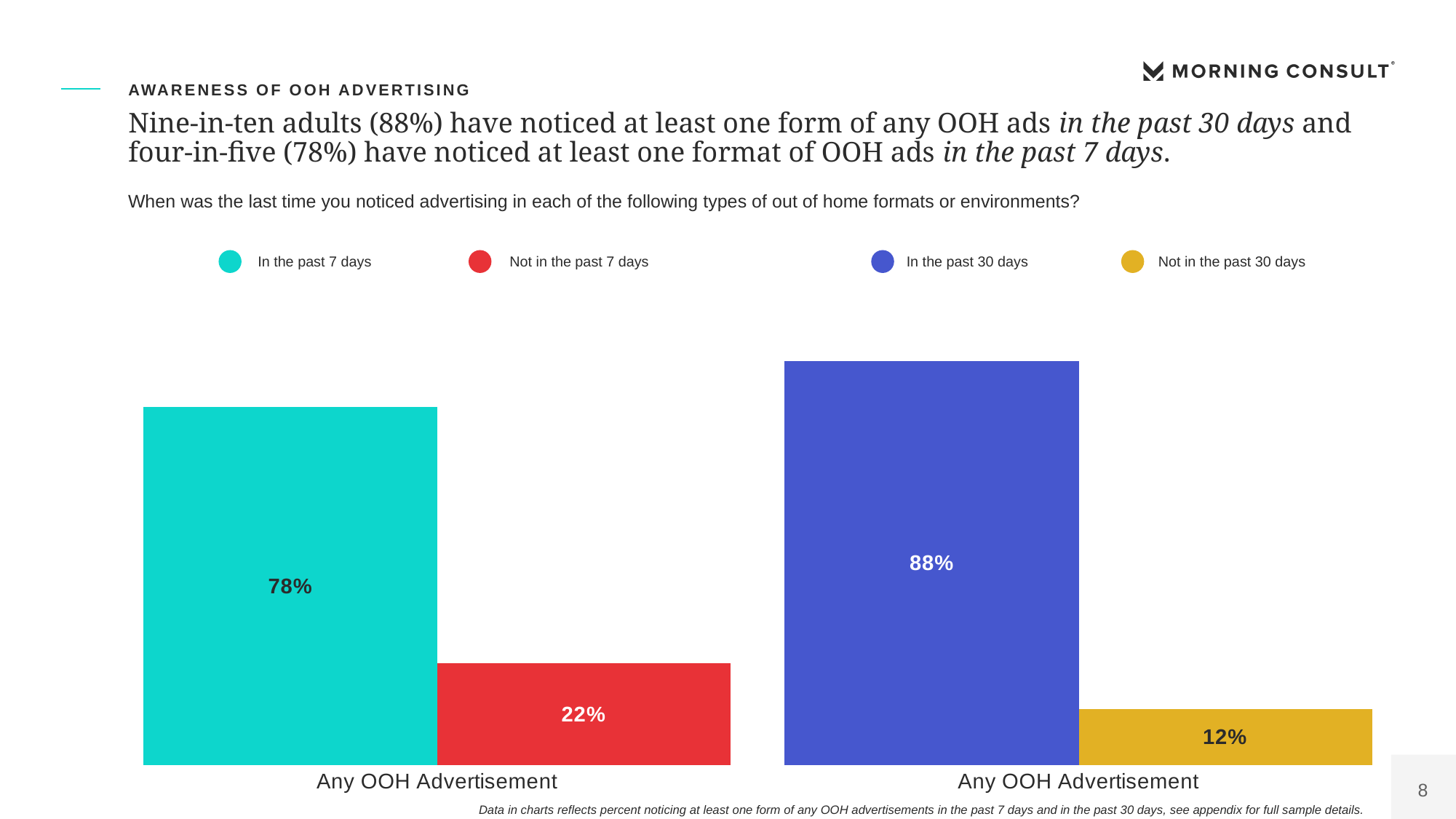
What percentage of adults did not notice any OOH advertisement in the past 7 days? 22% What colour is the bar for 'Not in the past 30 days'? Yellow What percentage of adults did not notice any OOH advertisement in the past 30 days? 12% What kind of chart is shown on the slide? Bar chart What percentage of adults noticed any OOH advertisement in the past 30 days? 88% What is the difference between the 'Not in the past 7 days' value and the 'Not in the past 30 days' value? 10% Which series has the lowest value in the chart? Not in the past 30 days Which is larger, the 'In the past 7 days' value or the 'Not in the past 7 days' value? In the past 7 days Which series has the highest value in the chart? In the past 30 days What percentage of adults noticed any OOH advertisement in the past 7 days? 78% What is the difference between the 'In the past 30 days' value and the 'In the past 7 days' value? 10% How many series does the legend list? 4